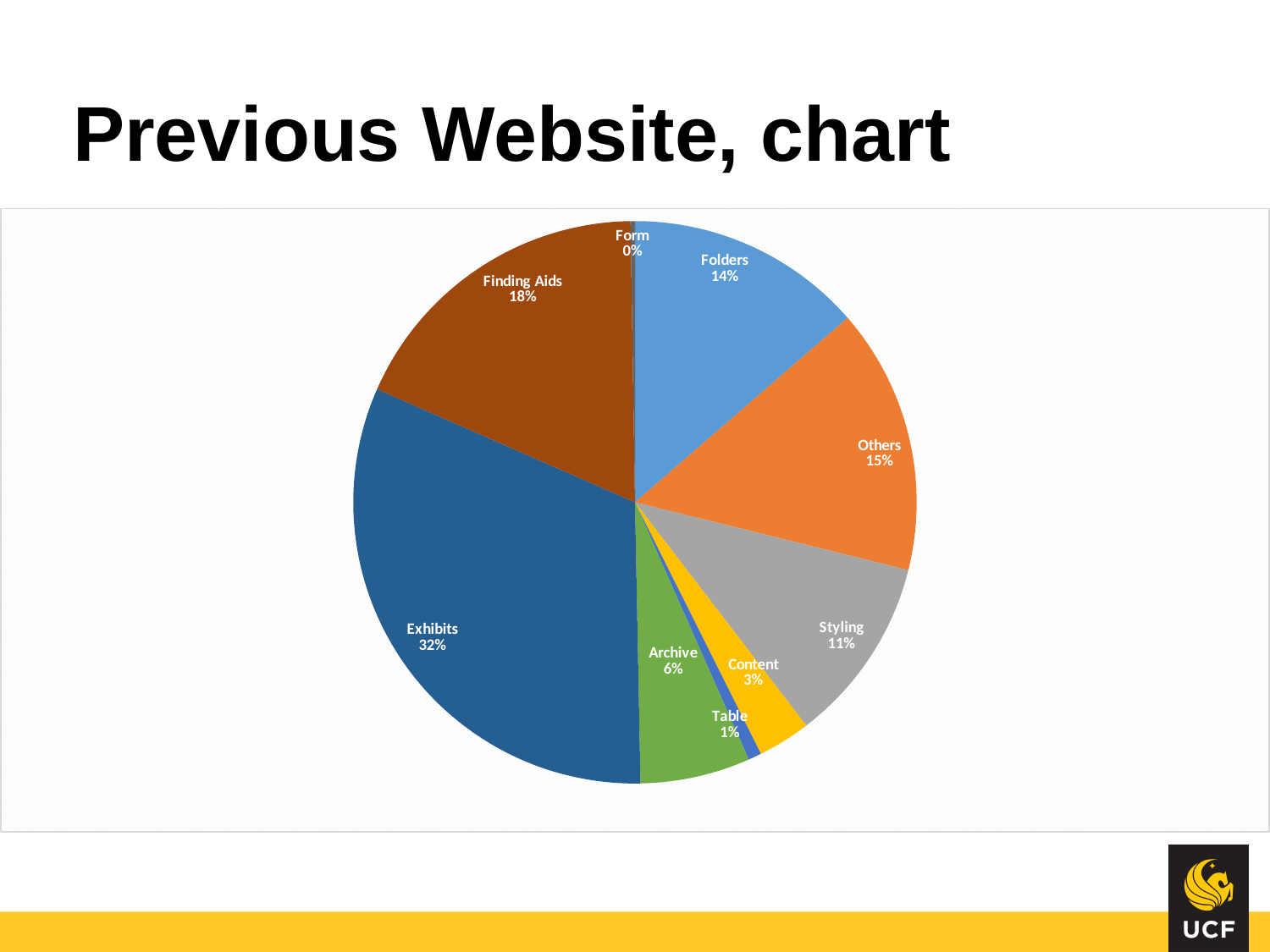
Which category has the largest slice of the pie? Exhibits What is the value shown for Finding Aids? 18% What is the value shown for Styling? 11% What is the title of the slide containing the chart? Previous Website, chart What is the difference between the Exhibits and Finding Aids percentages? 14% What kind of chart is shown on the slide? pie chart What is the value shown for Archive? 6% What is the difference between the Others and Folders percentages? 1% Which category has the smallest slice of the pie? Form Which is larger, Finding Aids or Styling? Finding Aids How many categories are shown in the pie chart? 9 What share of the pie does Exhibits take? 32%